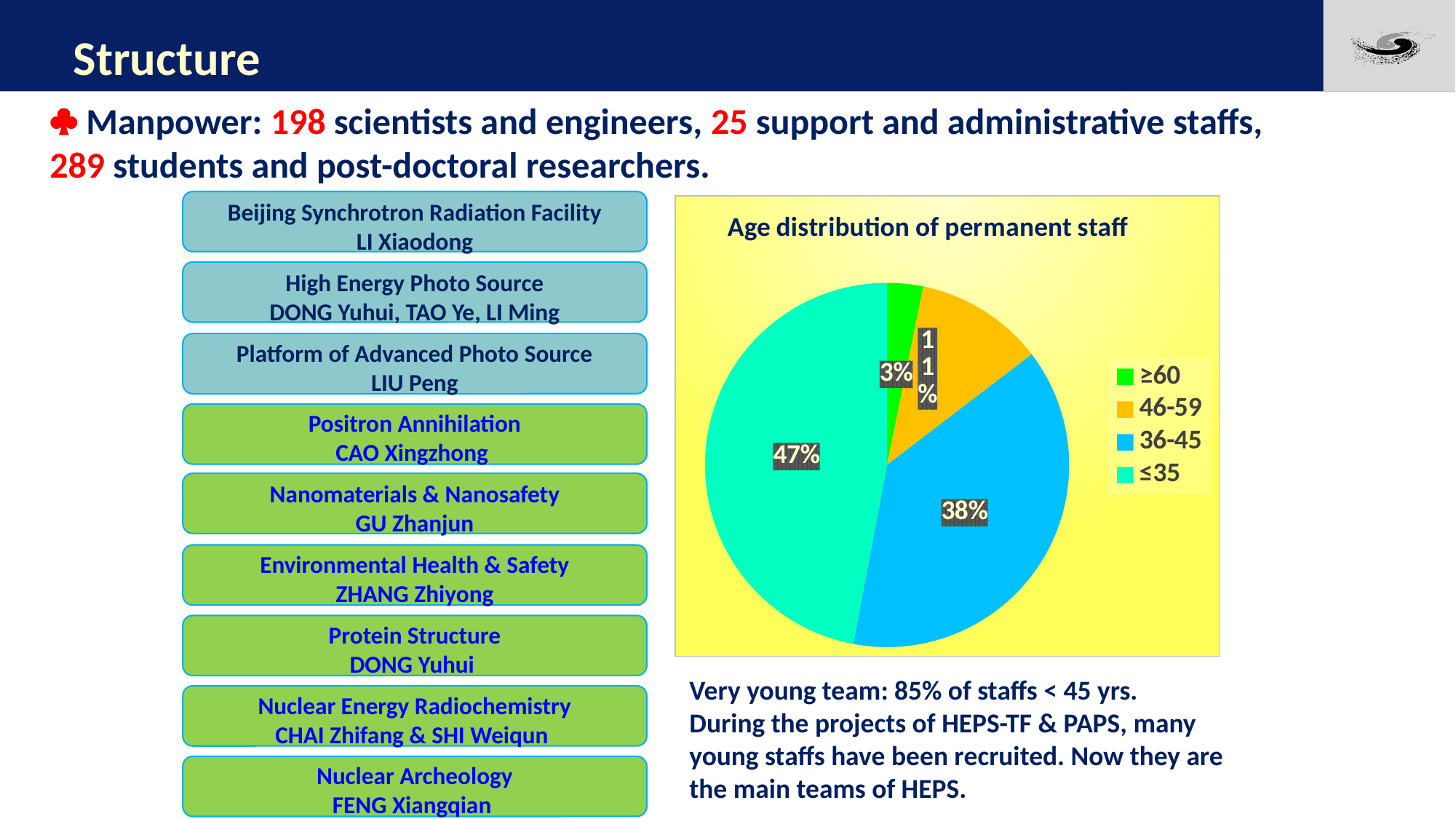
What colour represents the 36-45 age group in the pie chart? blue What share of permanent staff is aged 36-45? 38% What is the title of the chart? Age distribution of permanent staff Which age group has the largest share of permanent staff? ≤35 What share of permanent staff is aged ≥60? 3% What is the difference in percentage points between the ≤35 and 36-45 age groups? 9 What kind of chart is shown on the slide? pie chart Which age group has the smallest share of permanent staff? ≥60 How many age groups does the legend list? 4 Which age group has a larger share, 46-59 or ≥60? 46-59 What share of permanent staff is aged 46-59? 11% What share of permanent staff is aged ≤35? 47%